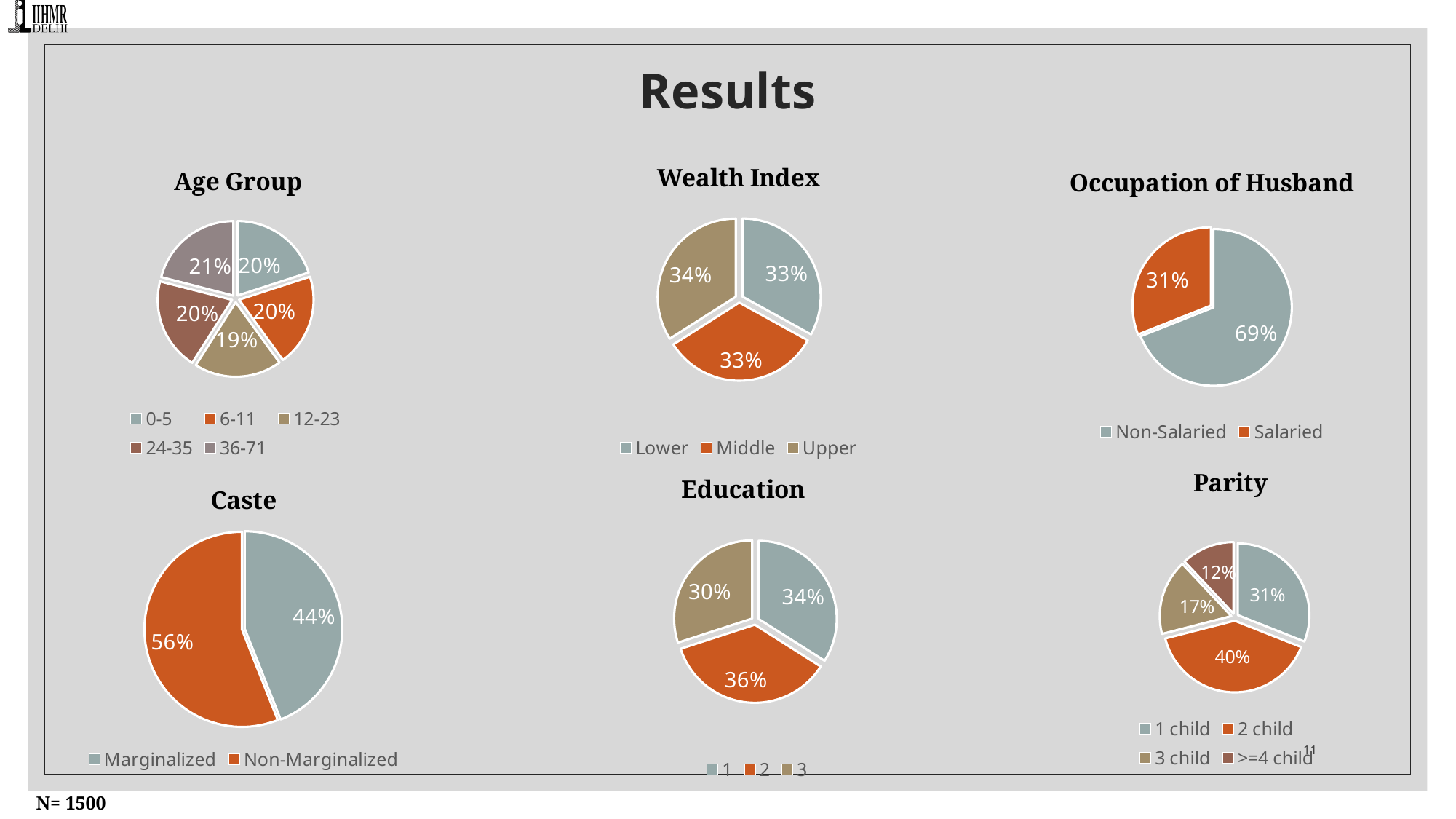
In the Occupation of Husband chart, what percentage is Non-Salaried? 69% In the Occupation of Husband chart, what is the difference between Non-Salaried and Salaried? 38% In the Parity chart, what percentage is 3 child? 17% In the Caste chart, which is larger, Marginalized or Non-Marginalized? Non-Marginalized In the Wealth Index chart, what percentage is Upper? 34% In the Parity chart, which category has the smallest share? >=4 child In the Caste chart, what share is Marginalized? 44% In the Education chart, which category has the smallest share? 3 How many categories does the Age Group chart show? 5 In the Age Group chart, what percentage is 12-23? 19% In the Parity chart, which category has the largest share? 2 child What type of chart is the Wealth Index chart? Pie chart